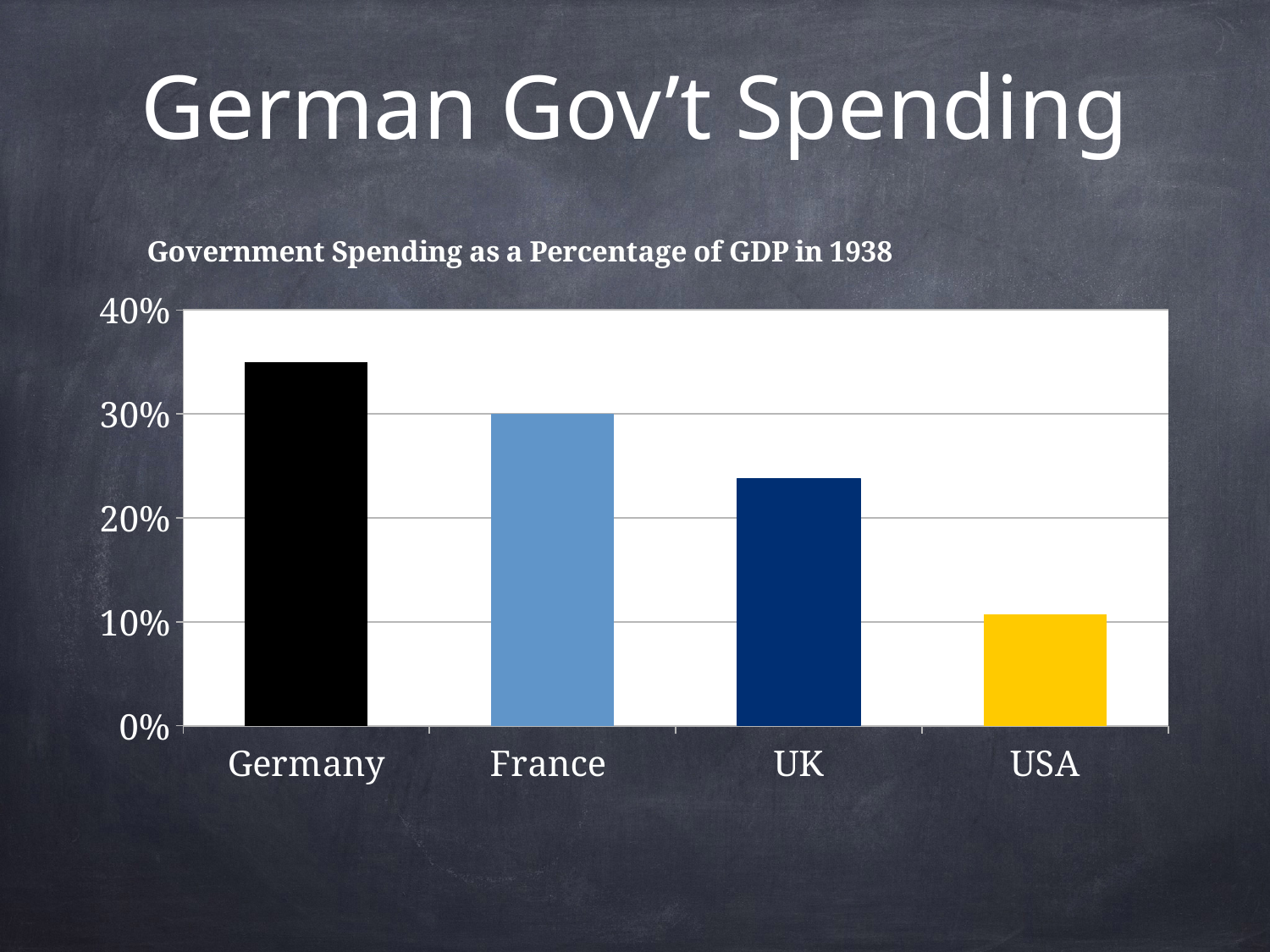
Which country has the lowest government spending as a percentage of GDP? USA Is the value for Germany greater or less than 40%? less Is the value for the UK greater or less than 20%? greater Do the values rise or fall moving from left to right across the countries? fall What kind of chart is shown on the slide? bar chart Which country has the highest government spending as a percentage of GDP? Germany How many countries are shown in the chart? 4 Is the value for Germany greater or less than 30%? greater What is the title of the chart? Government Spending as a Percentage of GDP in 1938 Which has the larger value, Germany or France? Germany Which has the larger value, the UK or the USA? UK